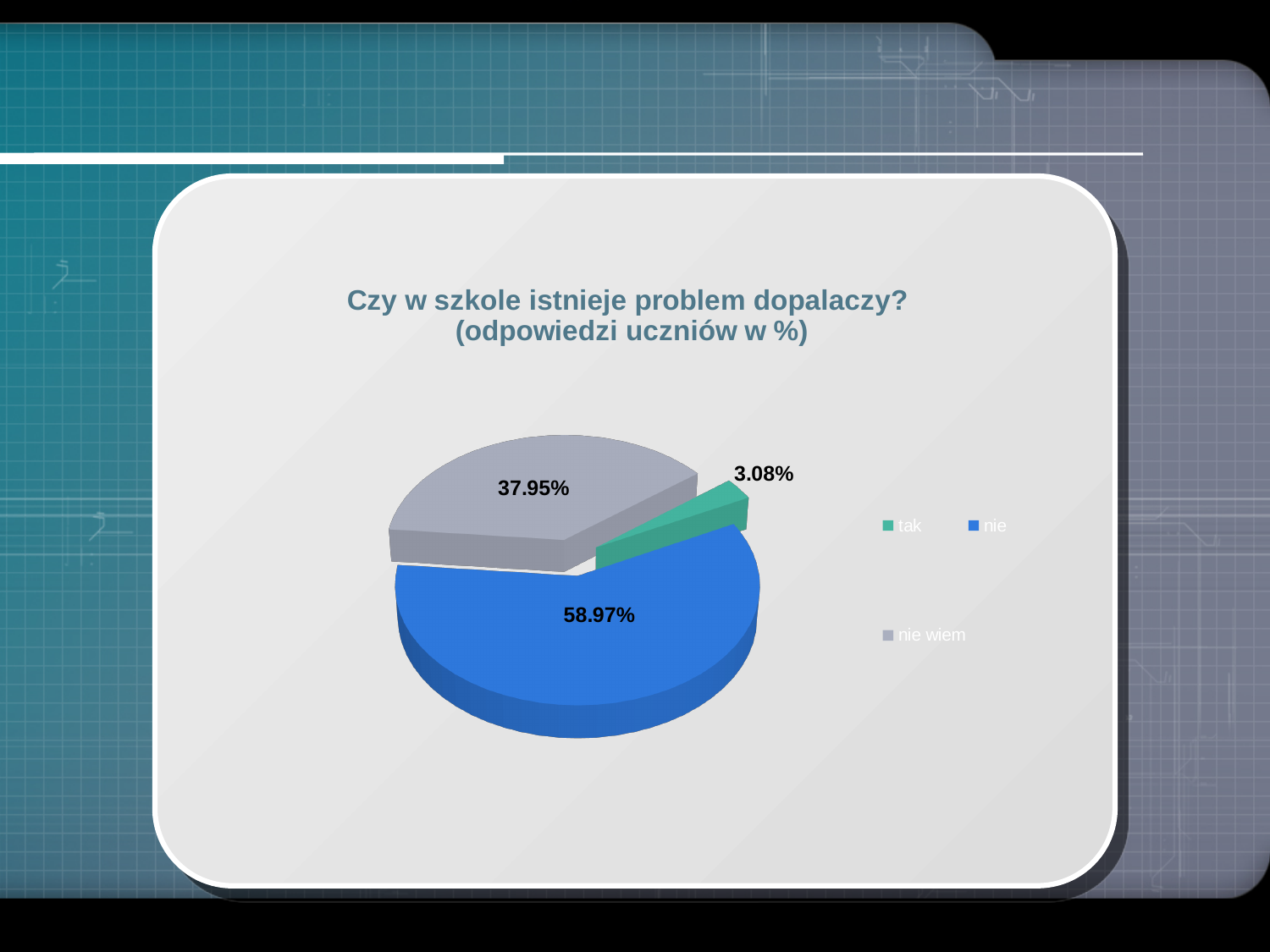
Which answer has the largest share of the pie? nie What is the title of the chart? Czy w szkole istnieje problem dopalaczy? (odpowiedzi uczniów w %) Which is larger, the share for "nie wiem" or the share for "tak"? nie wiem What is the difference in percentage points between the "nie" and "nie wiem" slices? 21.02 What percentage of students answered "tak"? 3.08% What kind of chart is shown on the slide? pie chart How many slices does the pie chart have? 3 Which answer has the smallest share of the pie? tak What percentage of students answered "nie"? 58.97% What colour is the slice for "nie"? blue What percentage of students answered "nie wiem"? 37.95% How many entries does the legend list? 3